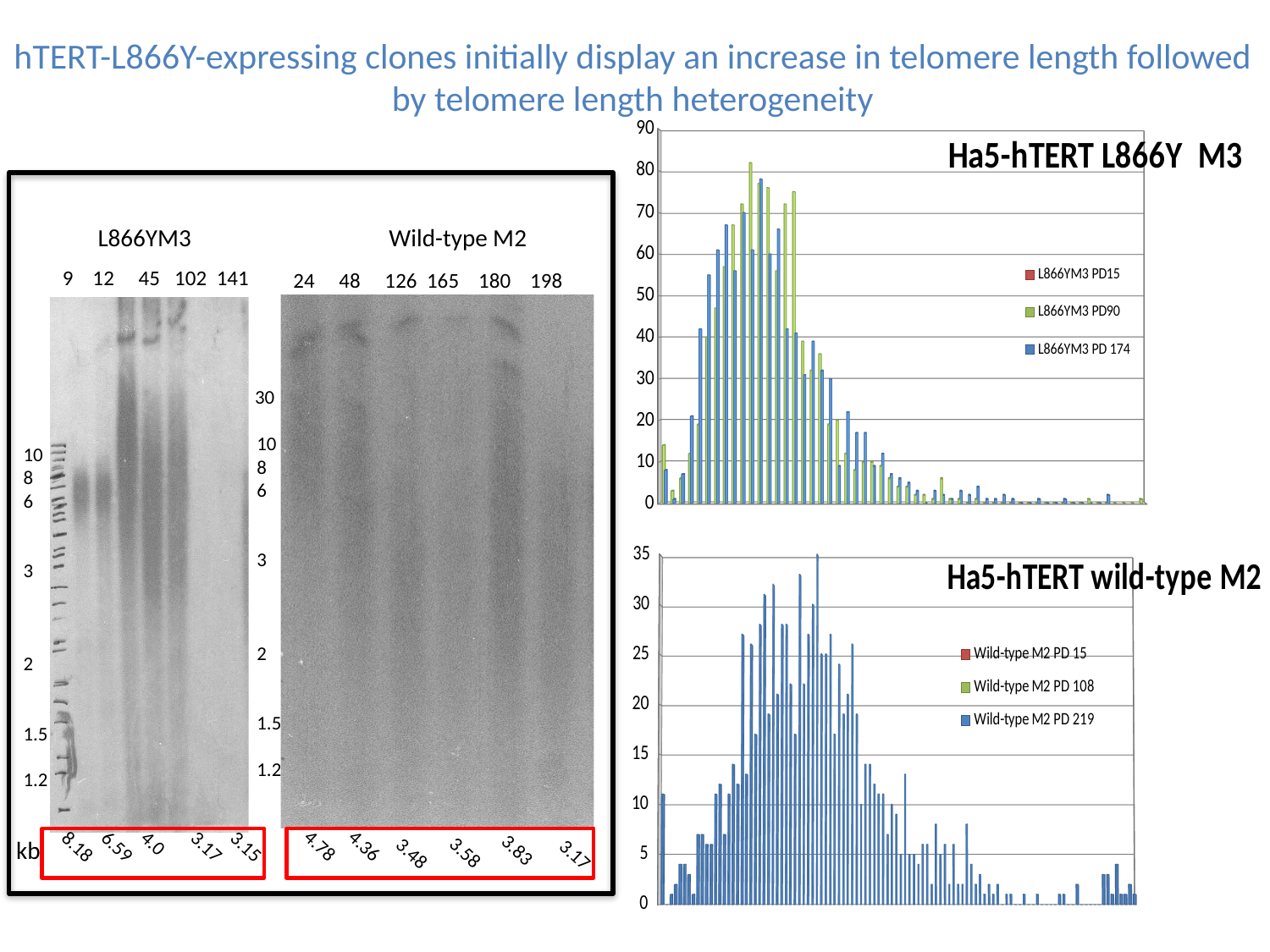
What is the highest value shown on the y axis of the 'Ha5-hTERT L866Y M3' chart? 90 How many series does the legend of the 'Ha5-hTERT L866Y M3' chart list? 3 What kind of chart is the 'Ha5-hTERT wild-type M2' chart? bar chart How many series does the legend of the 'Ha5-hTERT wild-type M2' chart list? 3 In the 'Ha5-hTERT L866Y M3' chart, is the tallest bar greater or less than 70? greater What kind of chart is the 'Ha5-hTERT L866Y M3' chart? bar chart In the 'Ha5-hTERT wild-type M2' chart, is the tallest bar greater or less than 30? greater What is the highest value shown on the y axis of the 'Ha5-hTERT wild-type M2' chart? 35